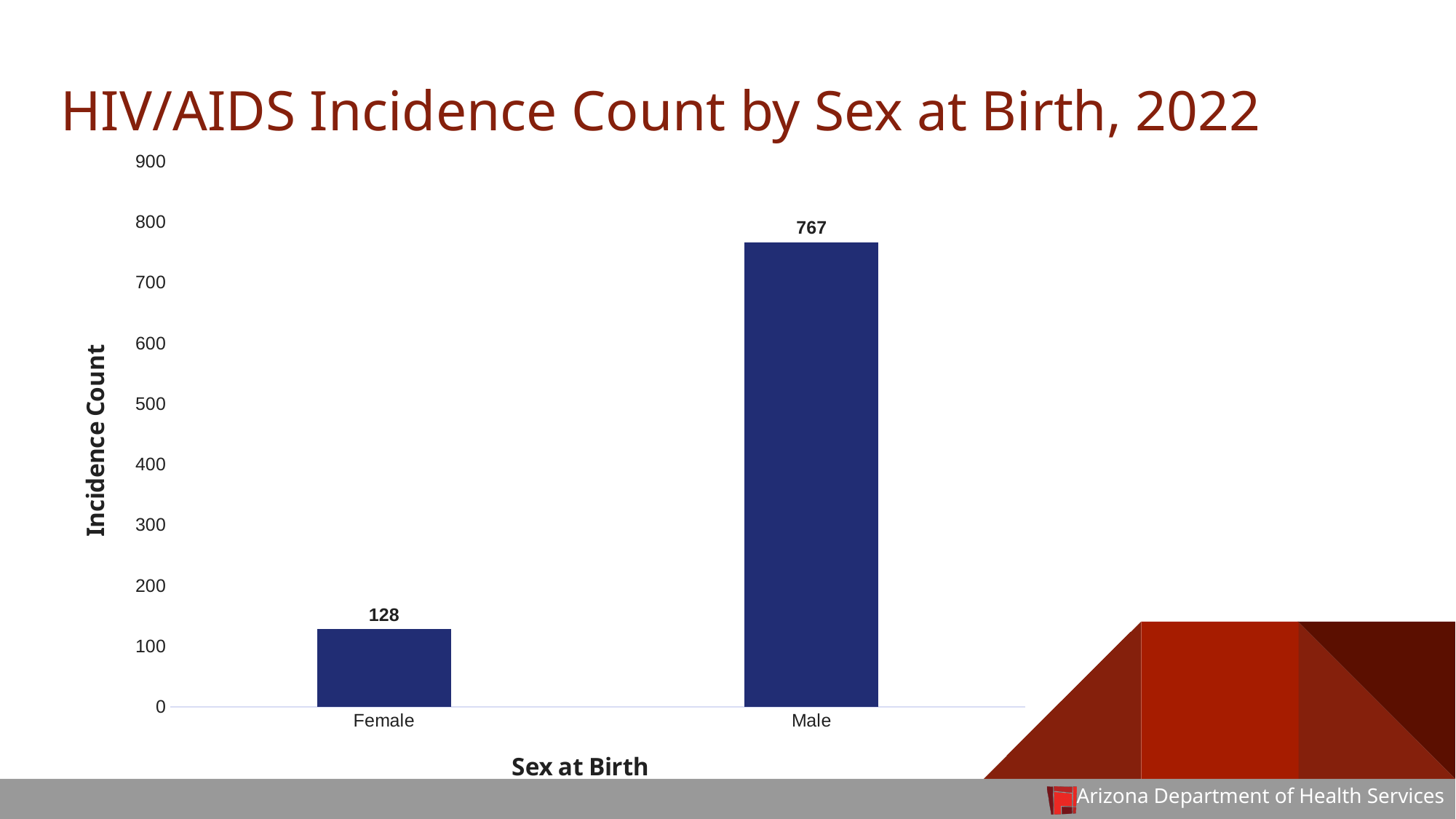
Which sex at birth has the lowest incidence count? Female What is the difference between the Male and Female incidence counts? 639 How many categories are shown on the x axis? 2 Is the value for Female greater or less than 200? less Which sex at birth has the highest incidence count? Male Is the value for Male greater or less than 700? greater What is the title of the chart? HIV/AIDS Incidence Count by Sex at Birth, 2022 What kind of chart is shown on the slide? bar chart Is the incidence count for Male larger or smaller than for Female? larger What is the incidence count for Male? 767 What is the incidence count for Female? 128 What is the label of the y axis? Incidence Count